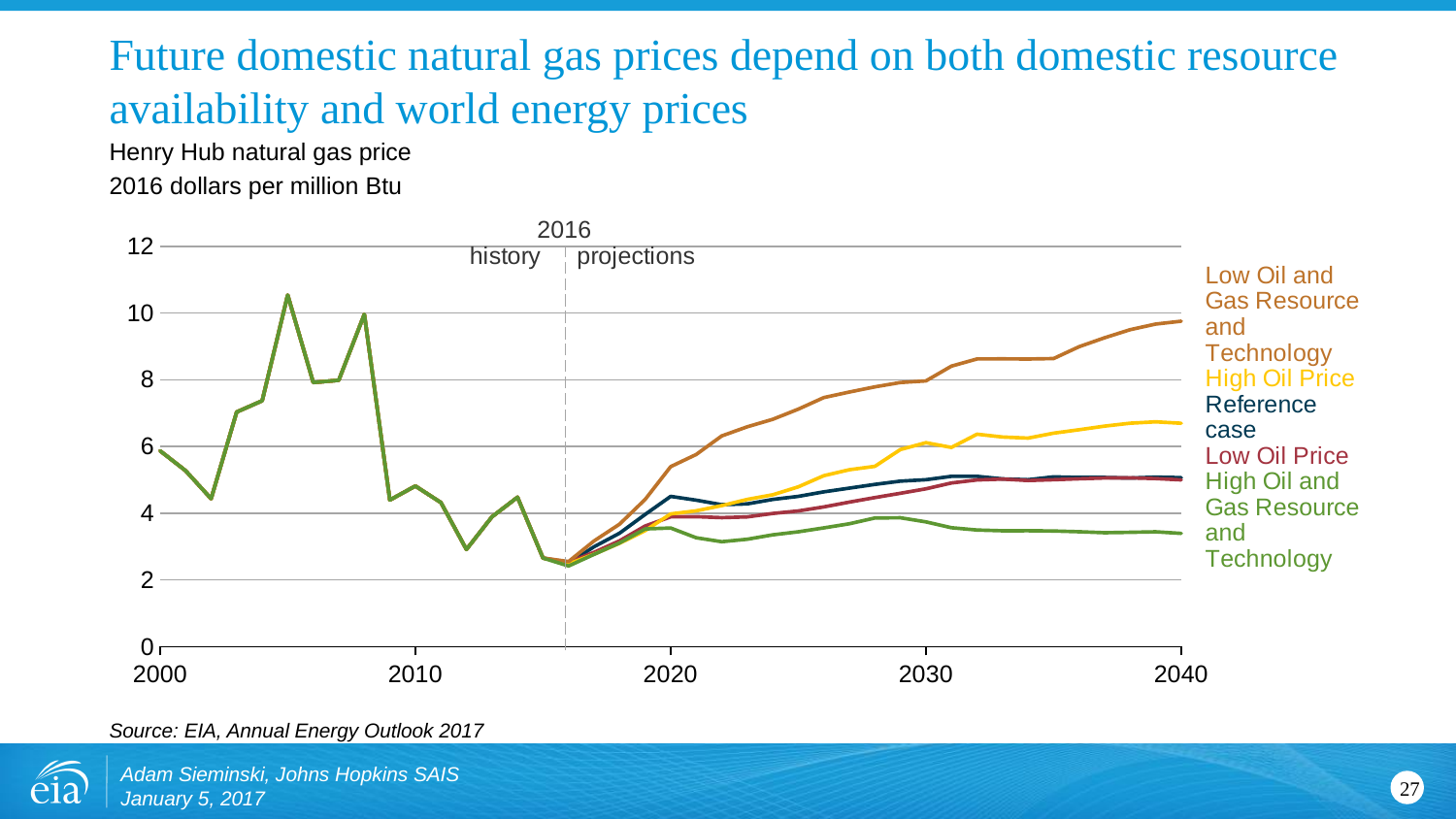
Does the Low Oil and Gas Resource and Technology line rise or fall between 2016 and 2040? rise Is the 2040 value for the Reference case greater or less than 4? greater Which series has the lowest Henry Hub natural gas price in 2040? High Oil and Gas Resource and Technology Which series has the highest Henry Hub natural gas price in 2040? Low Oil and Gas Resource and Technology In 2040, which is larger: the High Oil Price case or the Reference case? High Oil Price Is the 2040 value for the Low Oil and Gas Resource and Technology case greater or less than 8? greater Is the 2040 value for the High Oil Price case greater or less than 6? greater In what year does the chart switch from history to projections? 2016 What kind of chart is shown on the slide? line chart How many series does the legend list? 5 What units are the prices on the chart expressed in? 2016 dollars per million Btu